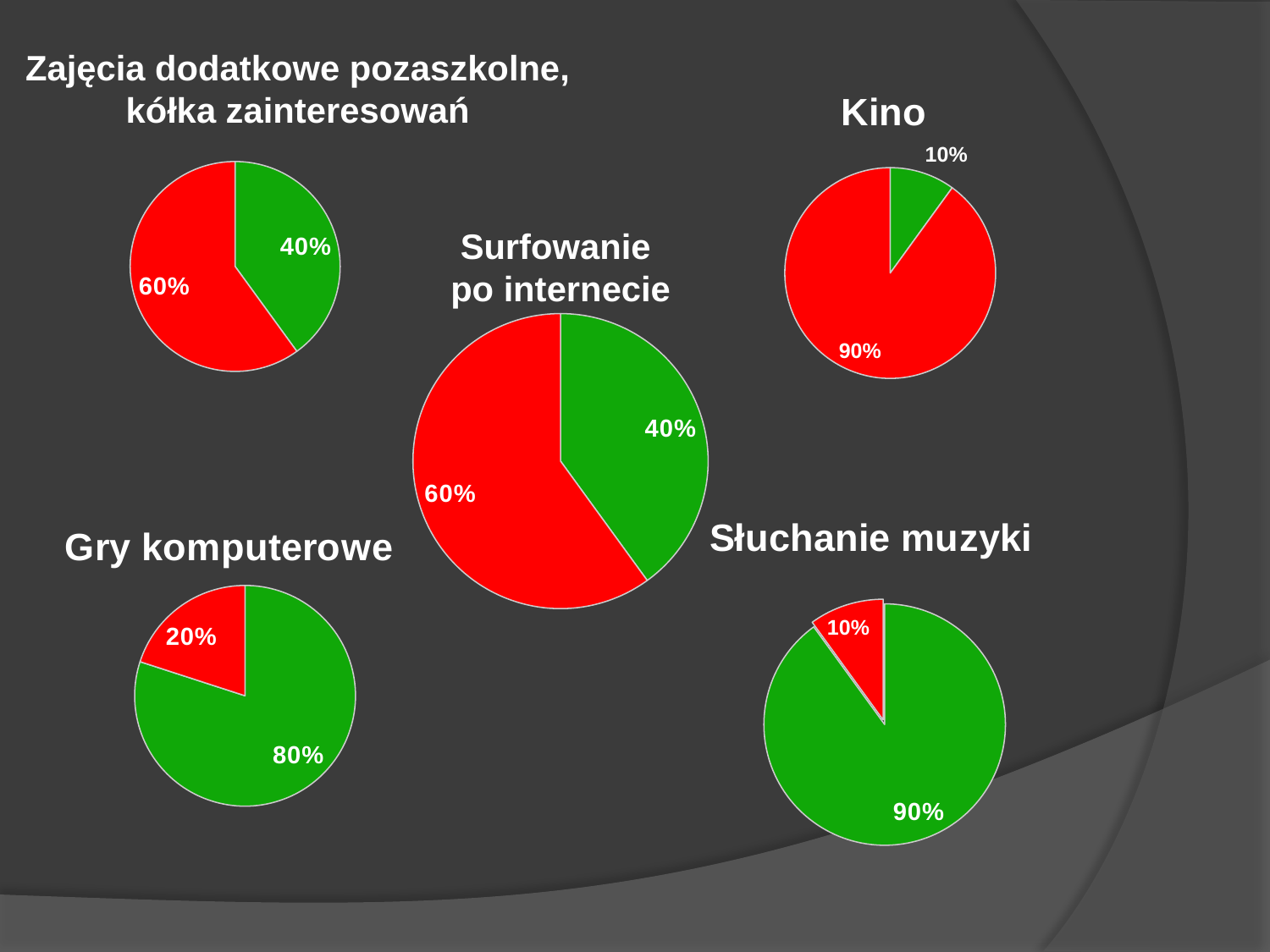
In the "Gry komputerowe" pie chart, what is the difference between the green slice and the red slice? 60% In the "Kino" pie chart, what percentage does the red slice show? 90% In the "Słuchanie muzyki" pie chart, which slice is the largest? the green slice (90%) In the "Zajęcia dodatkowe pozaszkolne, kółka zainteresowań" pie chart, what percentage does the green slice show? 40% What kind of chart is used for "Gry komputerowe"? pie chart In the "Surfowanie po internecie" pie chart, which slice is larger, the red one or the green one? the red one In the "Gry komputerowe" pie chart, what percentage does the green slice show? 80% In the "Słuchanie muzyki" pie chart, what percentage does the red slice show? 10% In the "Kino" pie chart, what percentage does the green slice show? 10% How many pie charts are shown on the slide? 5 How many slices does the "Kino" pie chart have? 2 In the "Surfowanie po internecie" pie chart, what percentage does the red slice show? 60%